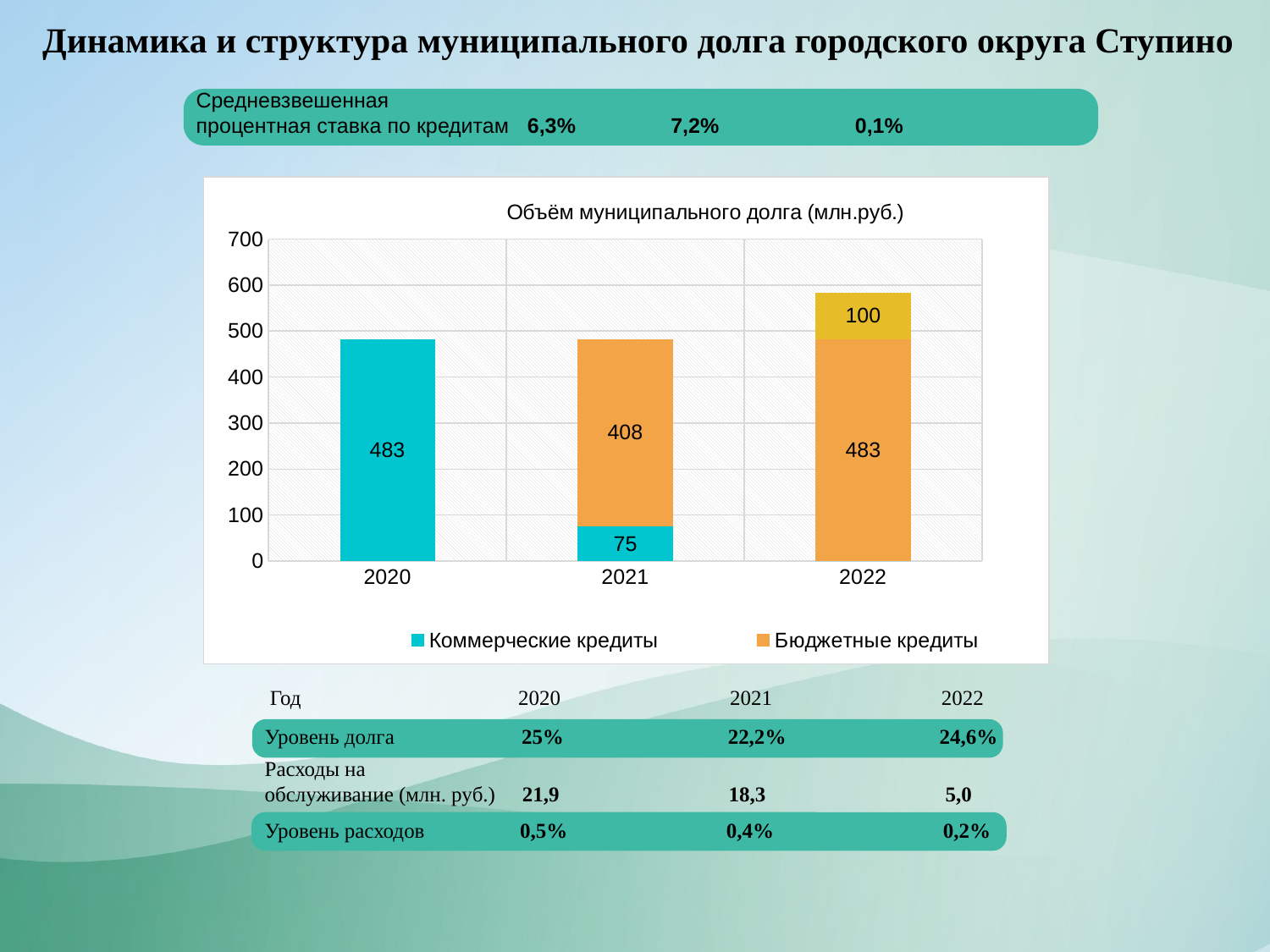
How many years are shown on the x axis of the chart? 3 What is the value of Бюджетные кредиты for 2022? 483 What is the total of the stacked bar for 2021? 483 Is the total height of the 2022 bar greater or less than 500? greater What is the value of Коммерческие кредиты for 2020? 483 How many series does the chart legend list? 2 What is the total of the stacked bar for 2022? 583 What is the title of the chart? Объём муниципального долга (млн.руб.) What is the difference between Бюджетные кредиты and Коммерческие кредиты in 2021? 333 What type of chart is shown on the slide? stacked bar chart What is the value of Коммерческие кредиты for 2021? 75 What is the value of Бюджетные кредиты for 2021? 408